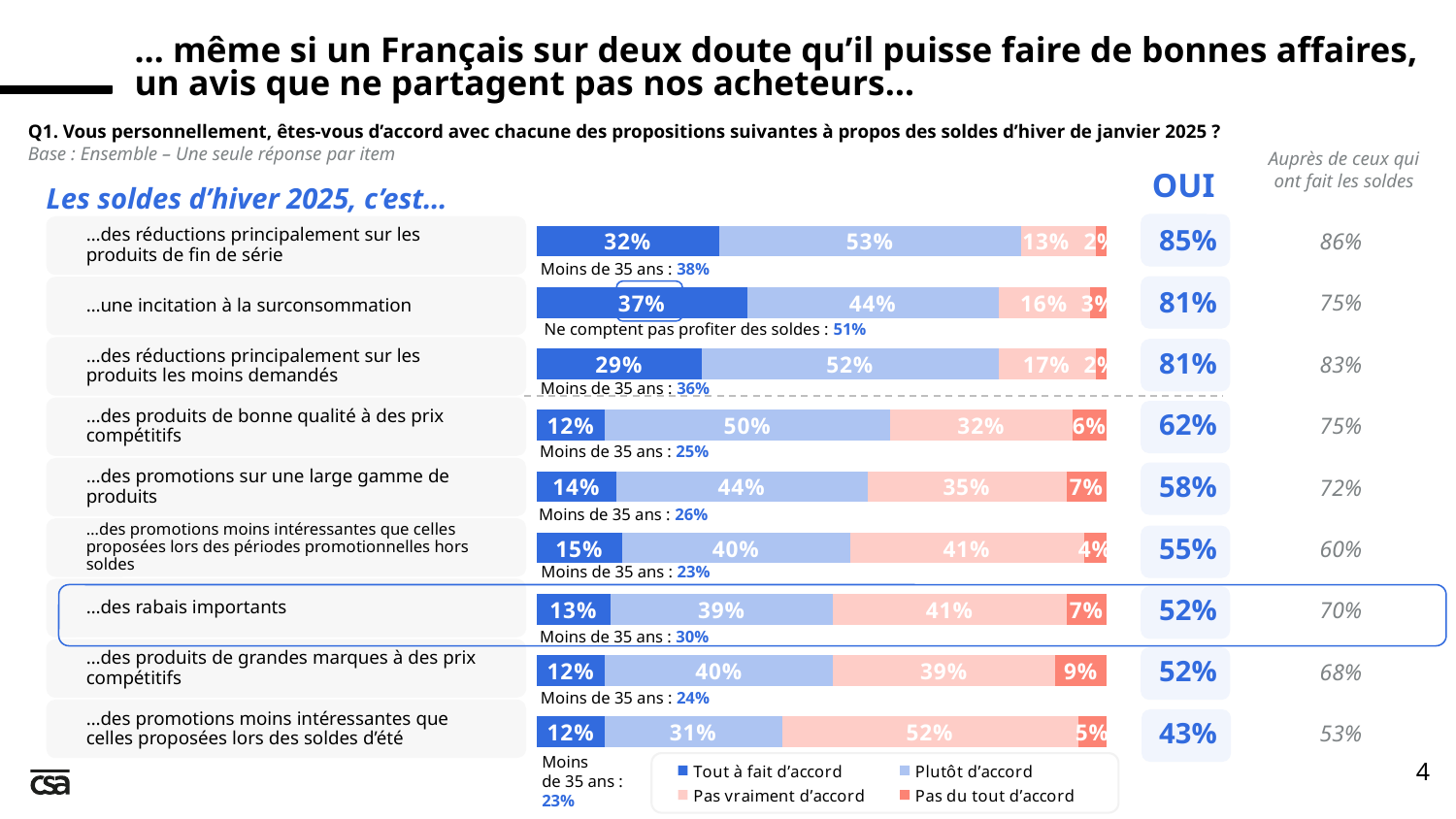
What is the difference between the 'OUI' value for '…des réductions principalement sur les produits de fin de série' and for '…des rabais importants'? 33% How many propositions (categories) are plotted in the chart? 9 What is the 'Pas du tout d'accord' value for '…des produits de grandes marques à des prix compétitifs'? 9% Which proposition has the highest 'Tout à fait d'accord' value? …une incitation à la surconsommation What type of chart is shown on the slide? Stacked bar chart Which is larger: the 'Plutôt d'accord' value for '…des produits de bonne qualité à des prix compétitifs' or for '…des promotions sur une large gamme de produits'? …des produits de bonne qualité à des prix compétitifs How many series does the legend list? 4 Which proposition has the lowest 'OUI' total? …des promotions moins intéressantes que celles proposées lors des soldes d'été What is the combined 'Tout à fait d'accord' plus 'Plutôt d'accord' total for '…des rabais importants'? 52% What is the 'Tout à fait d'accord' value for '…une incitation à la surconsommation'? 37% What is the 'Pas vraiment d'accord' value for '…des promotions moins intéressantes que celles proposées lors des soldes d'été'? 52% What is the 'Plutôt d'accord' value for '…des réductions principalement sur les produits de fin de série'? 53%